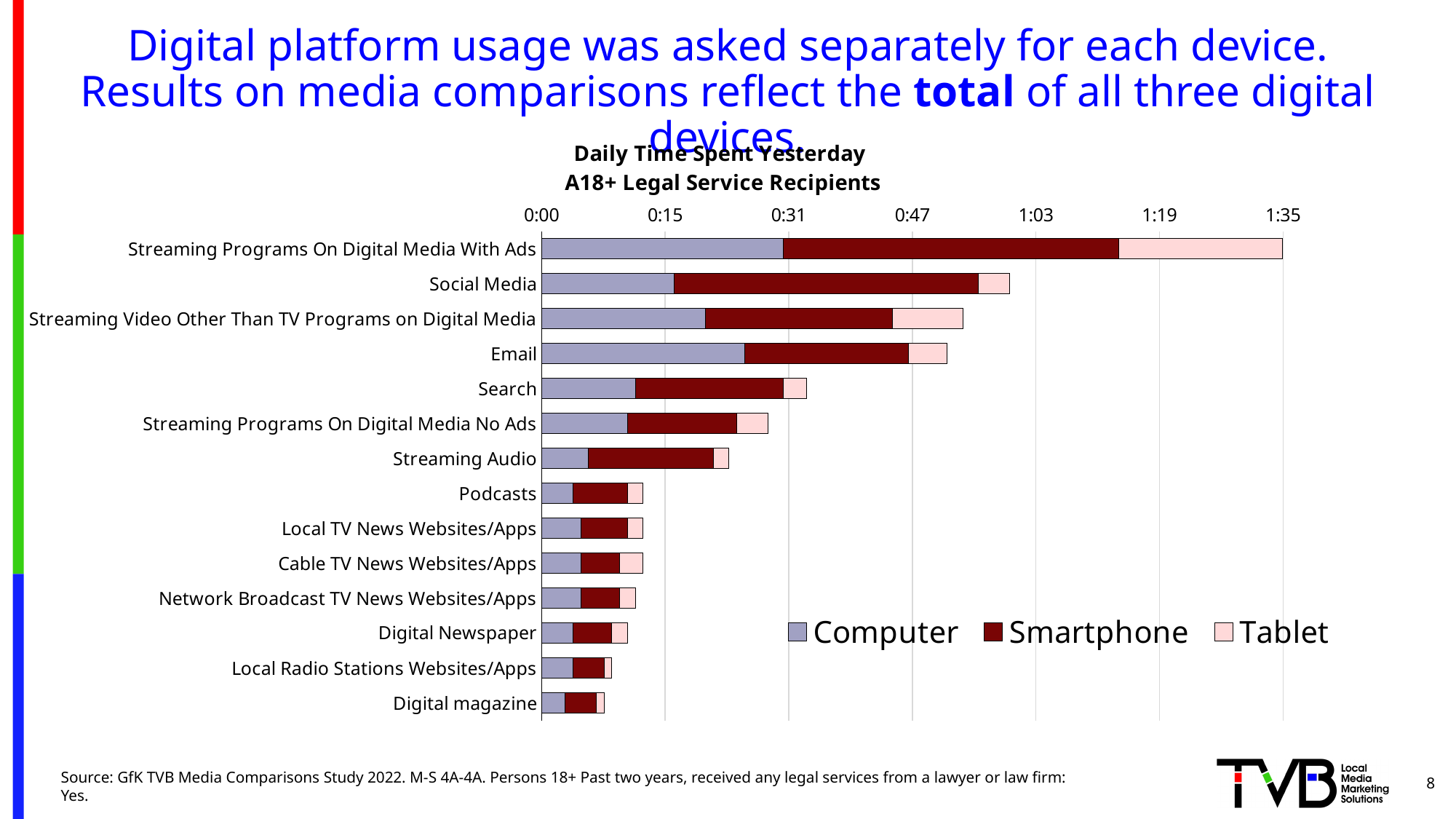
Is the total daily time for Social Media greater or less than 0:47? greater What kind of chart is shown on the slide? Stacked bar chart What is the second line of the chart title? A18+ Legal Service Recipients Which has a larger total daily time, Social Media or Email? Social Media How many categories are plotted on the chart? 14 Which category has the longest total bar? Streaming Programs On Digital Media With Ads Is the total daily time for Streaming Audio greater or less than 0:31? less Which series is shown in dark red in the legend? Smartphone How many series does the legend list? 3 Is the total daily time for Streaming Programs On Digital Media With Ads greater or less than 1:19? greater Which has a larger total daily time, Streaming Video Other Than TV Programs on Digital Media or Search? Streaming Video Other Than TV Programs on Digital Media